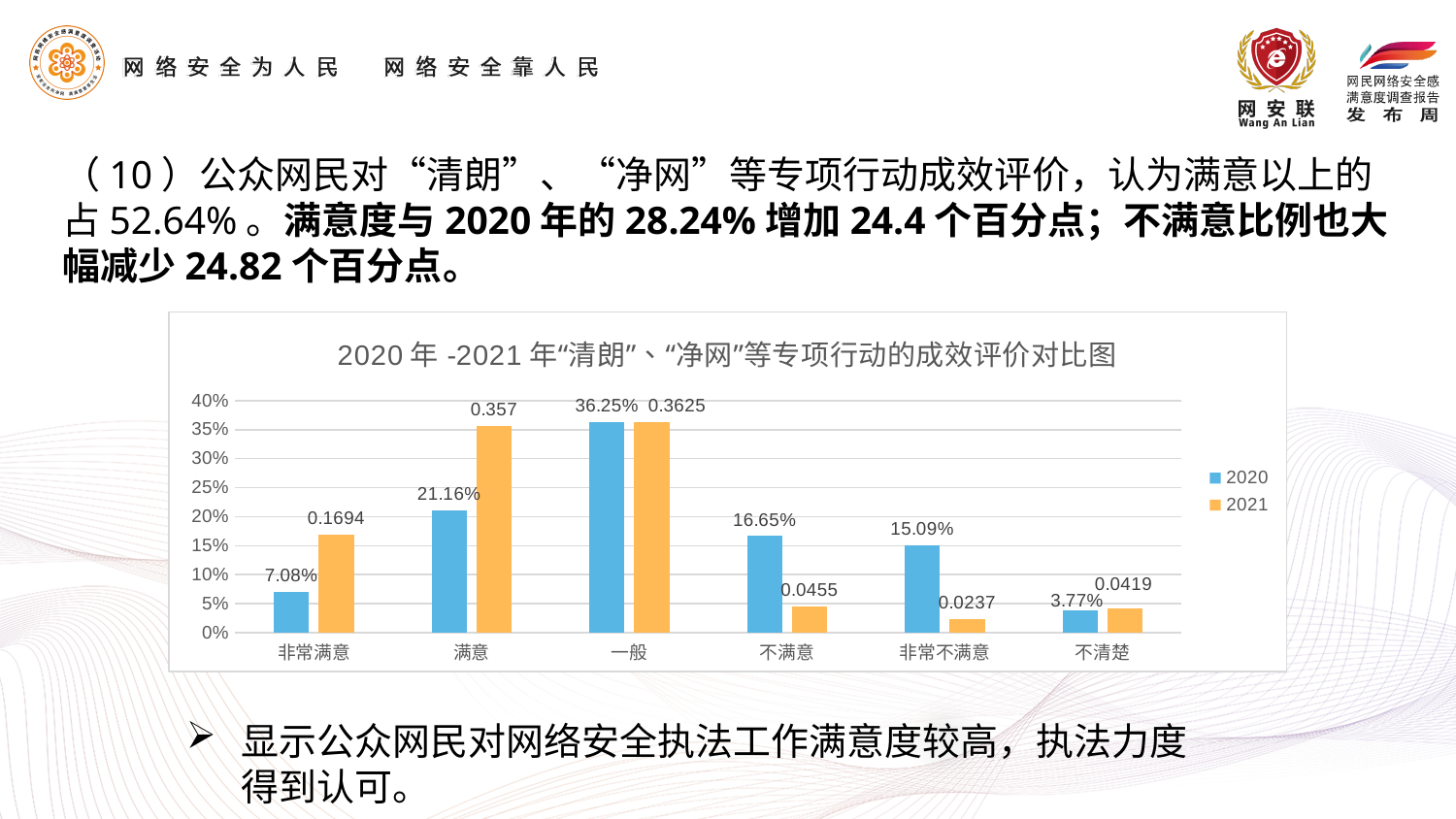
What is the difference between the 2020 values for 一般 and 非常满意? 29.17% How many categories are shown on the x axis? 6 Which is larger for 不满意: the 2020 value or the 2021 value? 2020 What is the 2021 value for 不清楚 as printed on the chart? 0.0419 How many series does the legend list? 2 What is the 2021 value for 非常满意 as printed on the chart? 0.1694 What is the 2020 value for 非常不满意? 15.09% What is the 2020 value for 满意? 21.16% What type of chart is shown on the slide? Bar chart Which category has the highest 2020 value? 一般 Which category has the lowest 2020 value? 不清楚 Which category has the lowest 2021 value? 非常不满意